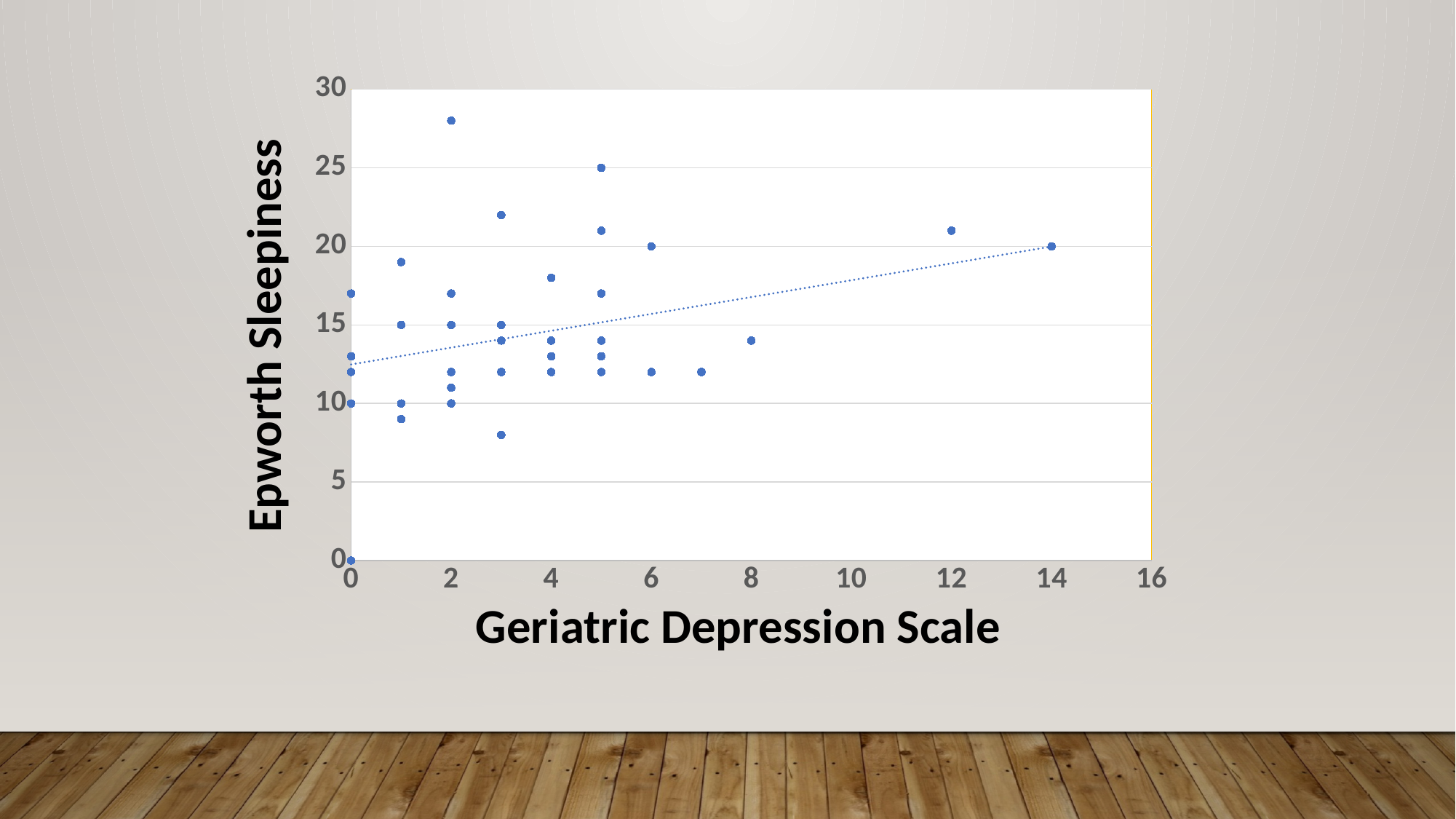
What is the maximum value shown on the y axis? 30 What is the title of the y axis? Epworth Sleepiness Does the dotted trend line rise or fall as the Geriatric Depression Scale increases? rises Is the Epworth Sleepiness value of the point at Geriatric Depression Scale 8 greater or less than 10? greater What is the highest Epworth Sleepiness value plotted at Geriatric Depression Scale 5? 25 What is the title of the x axis? Geriatric Depression Scale Is the Epworth Sleepiness value of the point at Geriatric Depression Scale 7 greater or less than 15? less What is the Epworth Sleepiness value of the point at Geriatric Depression Scale 14? 20 What is the highest Epworth Sleepiness value plotted at Geriatric Depression Scale 6? 20 Is the highest Epworth Sleepiness value on the chart greater or less than 25? greater At which Geriatric Depression Scale value does the point with the highest Epworth Sleepiness score appear? 2 What kind of chart is shown on the slide? scatter plot